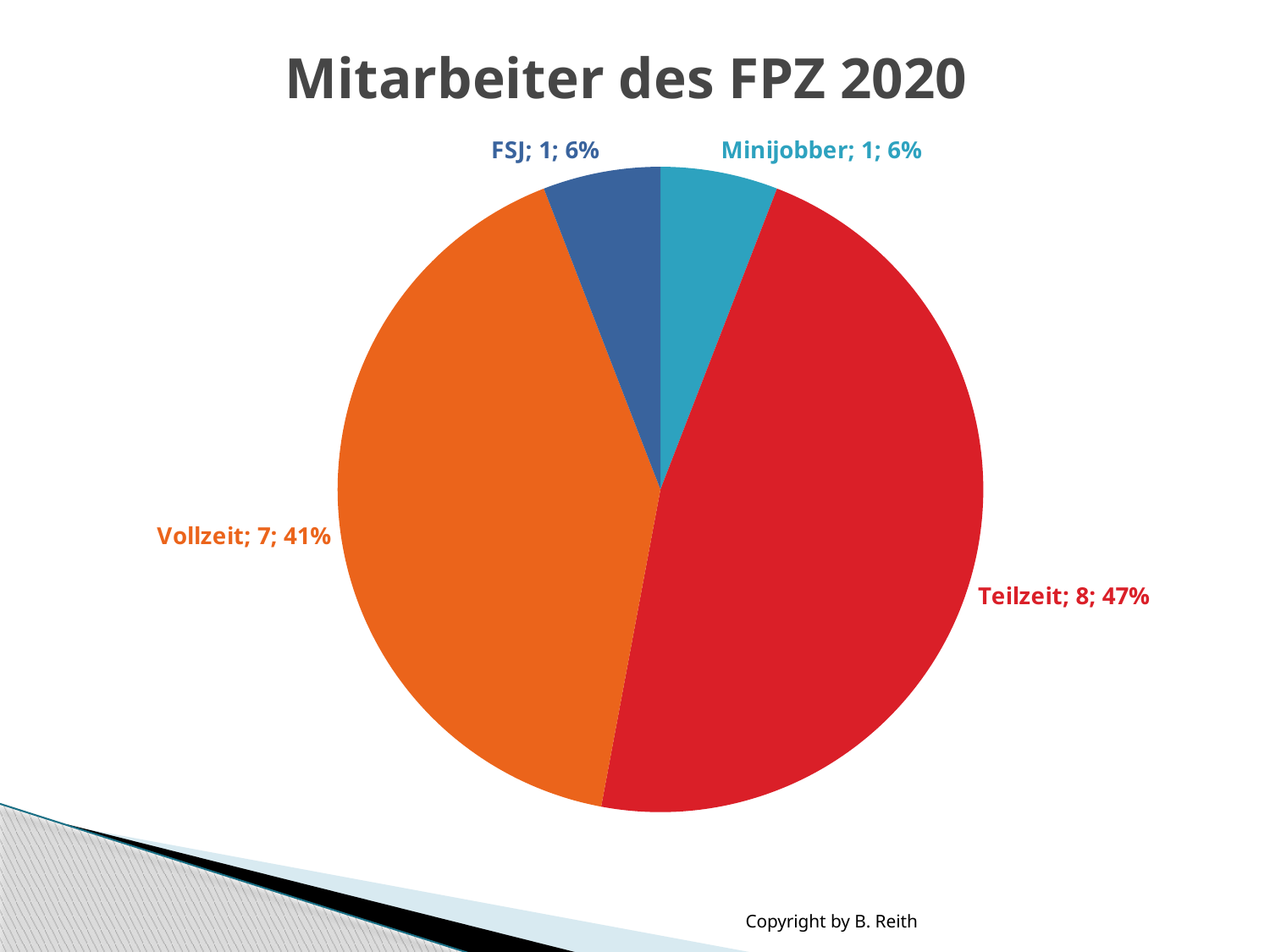
What kind of chart is shown on the slide? pie chart How many employees are in the Vollzeit category? 7 How many slices does the pie chart have? 4 What share of the pie does Vollzeit represent? 41% What is the difference in employee count between Teilzeit and Vollzeit? 1 What is the title of the chart? Mitarbeiter des FPZ 2020 Which category has the largest slice? Teilzeit What colour is the Teilzeit slice? red What is the total number of employees across all slices? 17 How many employees are in the Teilzeit category? 8 What share of the pie does Minijobber represent? 6% Which is larger, the Vollzeit slice or the FSJ slice? Vollzeit